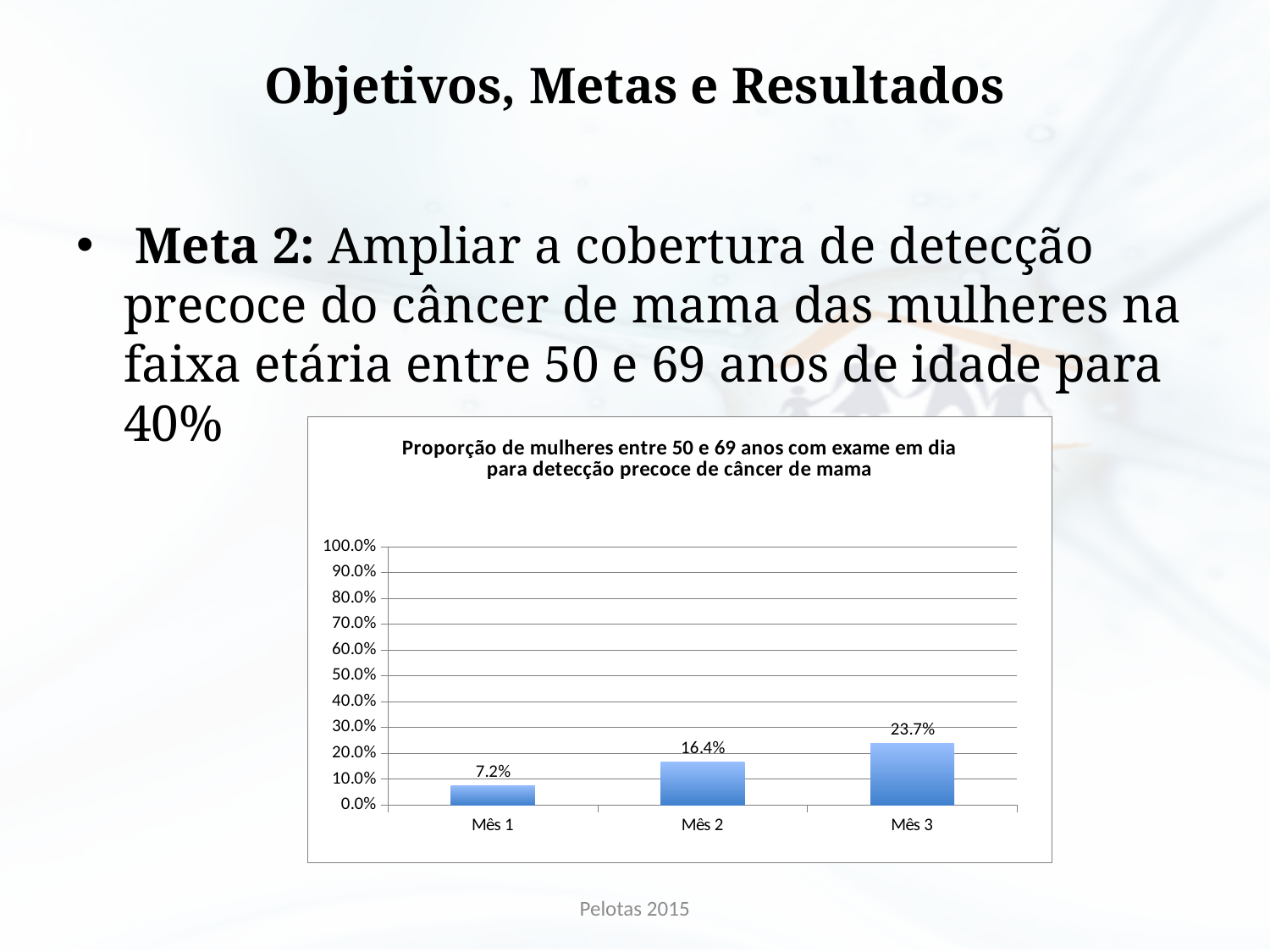
Do the values rise or fall from Mês 1 to Mês 3? rise What is the value for Mês 2? 16.4% Which month has the lowest value? Mês 1 Is the value for Mês 3 greater or less than 30.0%? less What is the value for Mês 1? 7.2% What is the difference between the values for Mês 2 and Mês 1? 9.2% What kind of chart is shown? bar chart Which is larger, the value for Mês 2 or the value for Mês 3? Mês 3 What is the value for Mês 3? 23.7% How many months are shown on the x axis? 3 What is the difference between the values for Mês 3 and Mês 1? 16.5% Which month has the highest value? Mês 3